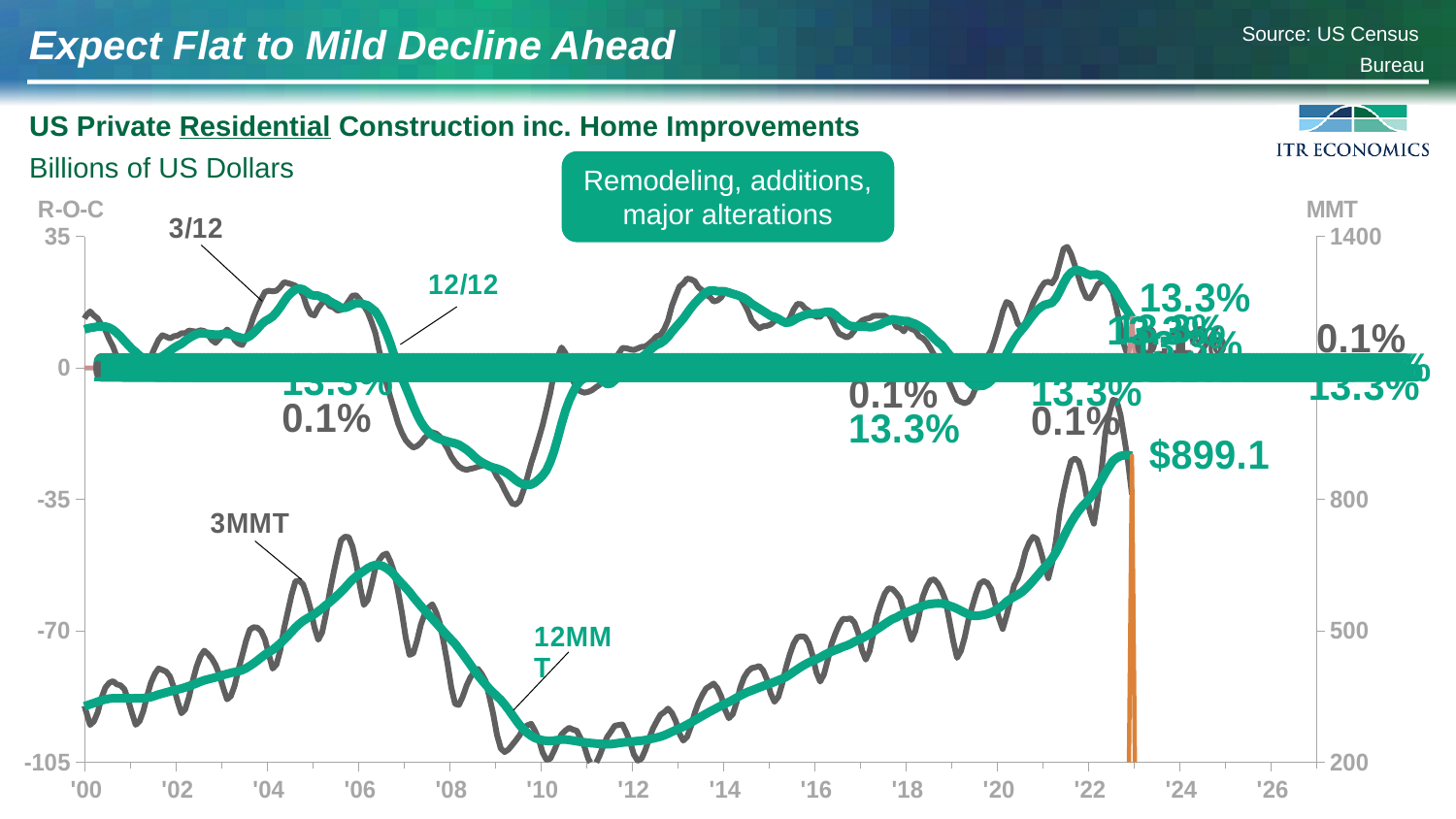
Does the 12MMT line rise or fall between '12 and '22? rise Is the 12/12 rate-of-change value around '21 greater or less than 0? greater What is the highest value shown on the right-hand MMT axis? 1400 What is the lowest value shown on the left-hand R-O-C axis? -105 How many labeled data series are plotted on the chart? 4 What is the title of the chart on the slide? US Private Residential Construction inc. Home Improvements Does the 12MMT line rise or fall between '06 and '10? fall What unit is the chart measured in, according to the subtitle? Billions of US Dollars Is the 12/12 rate-of-change value around '09 greater or less than 0? less What is the latest value printed for the 12MMT series on the chart? $899.1 What type of chart is shown on the slide? line chart Is the 12MMT value around '11 greater or less than 500 on the right axis? less